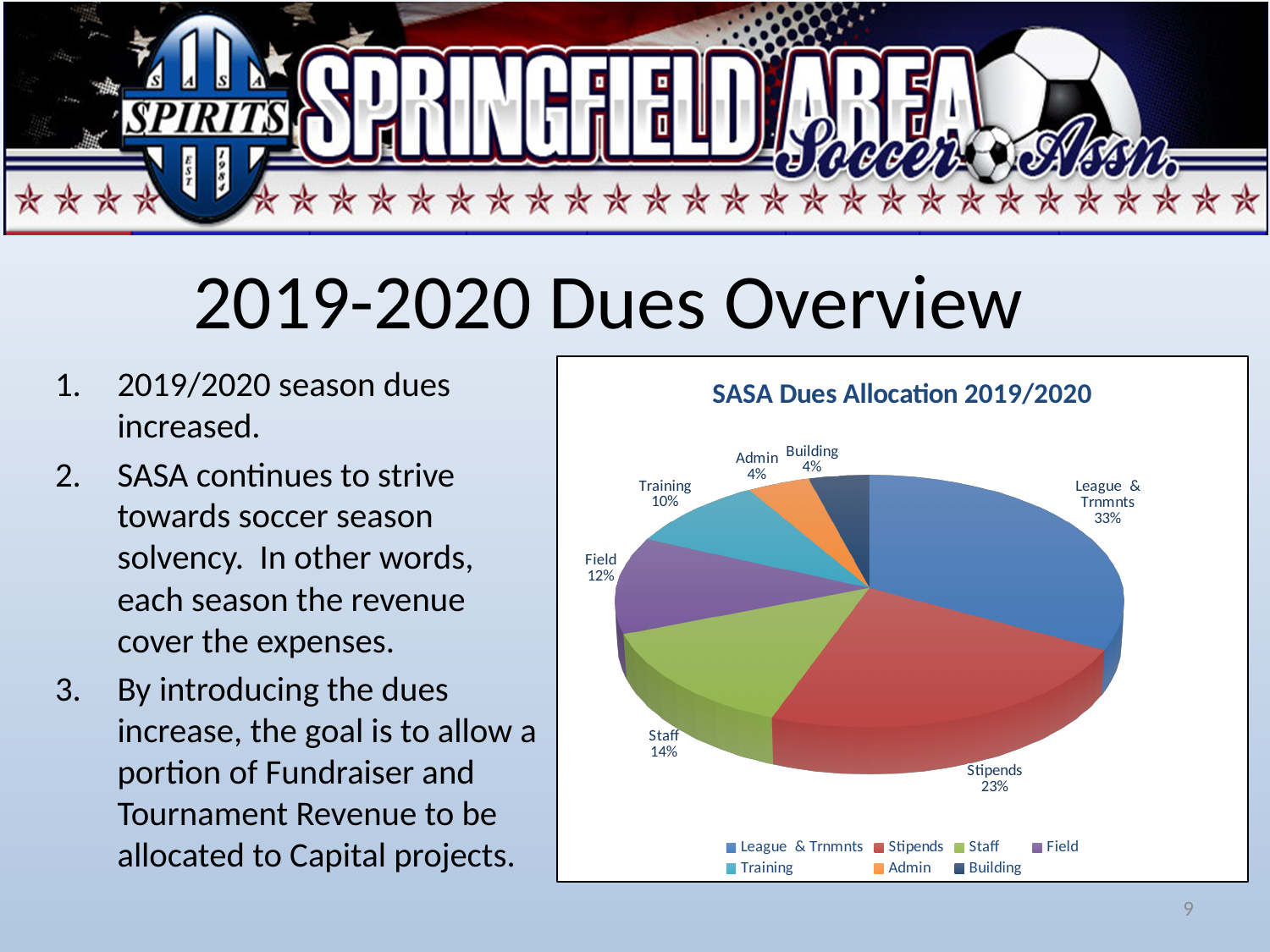
What is the title of the chart? SASA Dues Allocation 2019/2020 What share of dues is allocated to Staff? 14% What is the difference in percentage points between the Stipends and Field shares? 11 Which category has the largest share of the pie? League & Trnmnts Which is larger, the Field share or the Training share? Field How many entries does the legend list? 7 What share of dues is allocated to Building? 4% How many categories are shown in the pie chart? 7 What kind of chart is shown on the slide? Pie chart What share of dues is allocated to Stipends? 23% What is the share of the League & Trnmnts slice? 33% What share of dues is allocated to Training? 10%